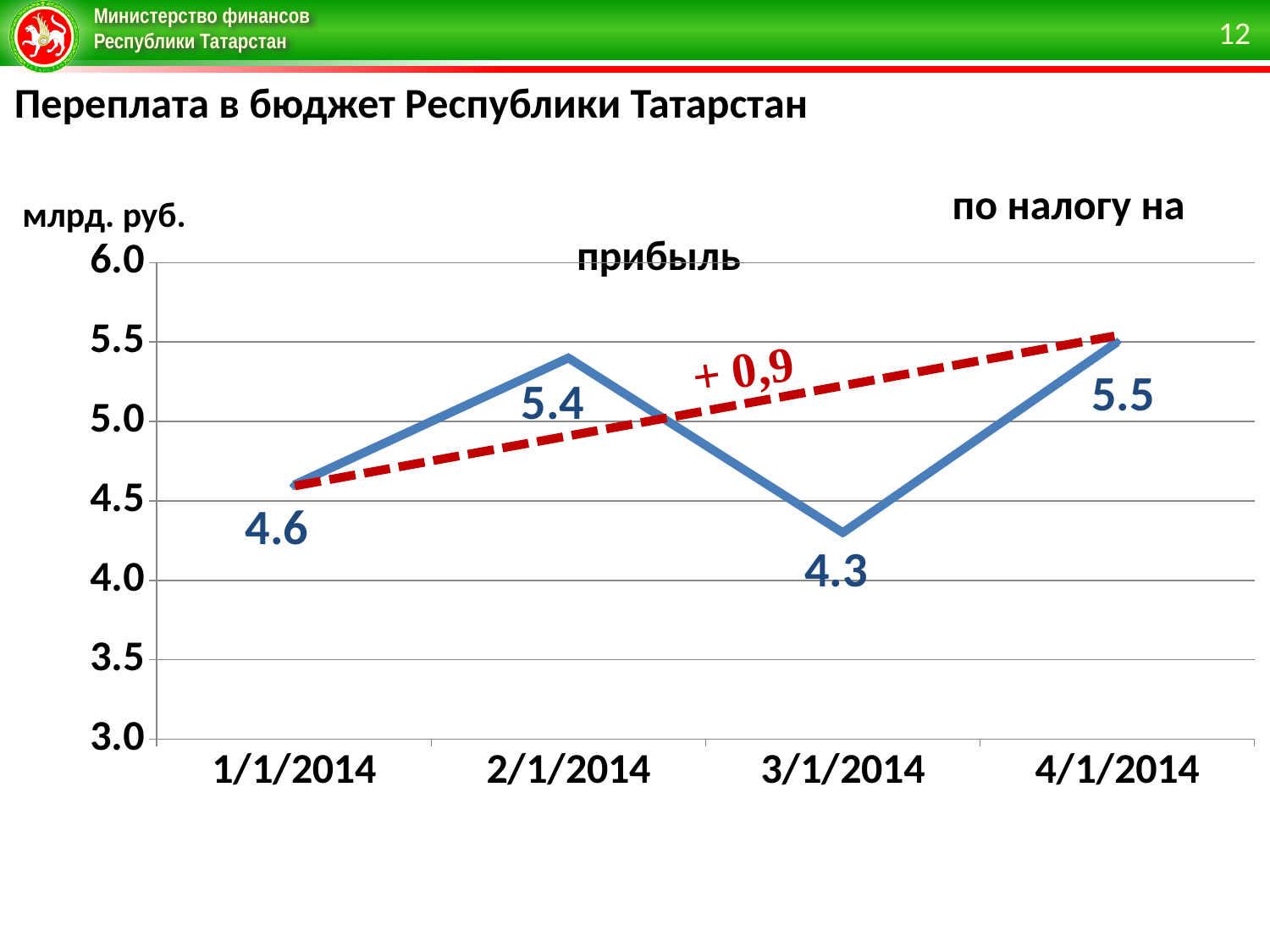
Which date has the highest value? 4/1/2014 Which is larger, the value for 2/1/2014 or the value for 3/1/2014? 2/1/2014 What is the difference between the values for 4/1/2014 and 1/1/2014? 0.9 What is the value for 1/1/2014? 4.6 What unit of measurement is shown for the chart's values? млрд. руб. What is the value for 3/1/2014? 4.3 What change is annotated next to the red dashed line on the chart? + 0,9 How many data points are plotted on the chart? 4 Which date has the lowest value? 3/1/2014 What is the value for 2/1/2014? 5.4 What kind of chart is shown on the slide? line chart What is the value for 4/1/2014? 5.5